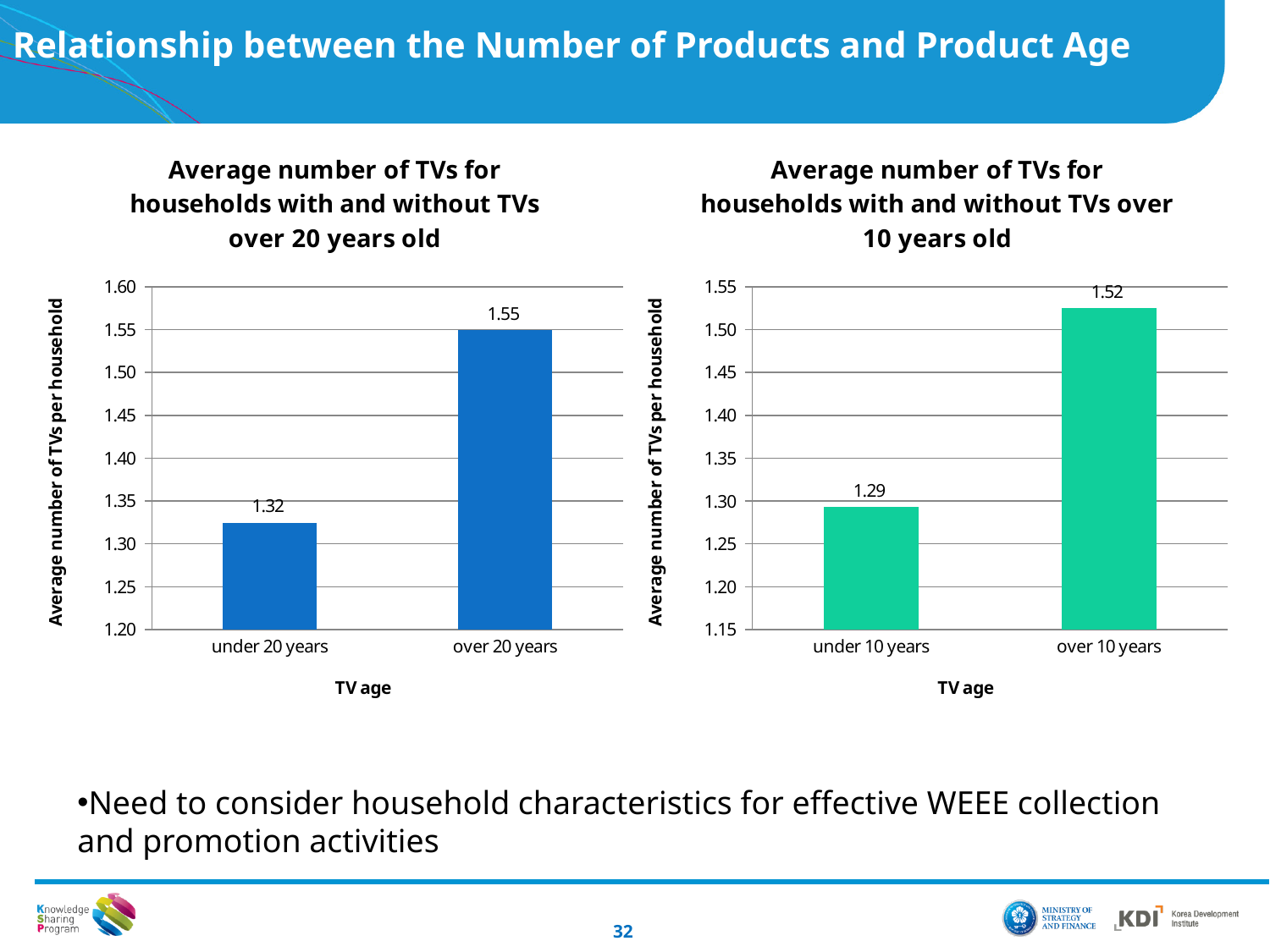
How many categories are shown on the x axis of the left chart (over 20 years old)? 2 In the left chart (over 20 years old), what is the average number of TVs per household for 'over 20 years'? 1.55 In the right chart (over 10 years old), what is the average number of TVs per household for 'over 10 years'? 1.52 In the right chart (over 10 years old), is the value for 'under 10 years' greater or less than 1.40? less In the left chart (over 20 years old), which category has the higher average number of TVs per household? over 20 years In the left chart (over 20 years old), what is the difference between the values for 'over 20 years' and 'under 20 years'? 0.23 In the right chart (over 10 years old), what is the average number of TVs per household for 'under 10 years'? 1.29 What is the x-axis title of the left chart (over 20 years old)? TV age In the left chart (over 20 years old), what is the average number of TVs per household for 'under 20 years'? 1.32 In the right chart (over 10 years old), what is the difference between the values for 'over 10 years' and 'under 10 years'? 0.23 What kind of chart is the right chart (over 10 years old)? bar chart In the right chart (over 10 years old), which category has the lower average number of TVs per household? under 10 years